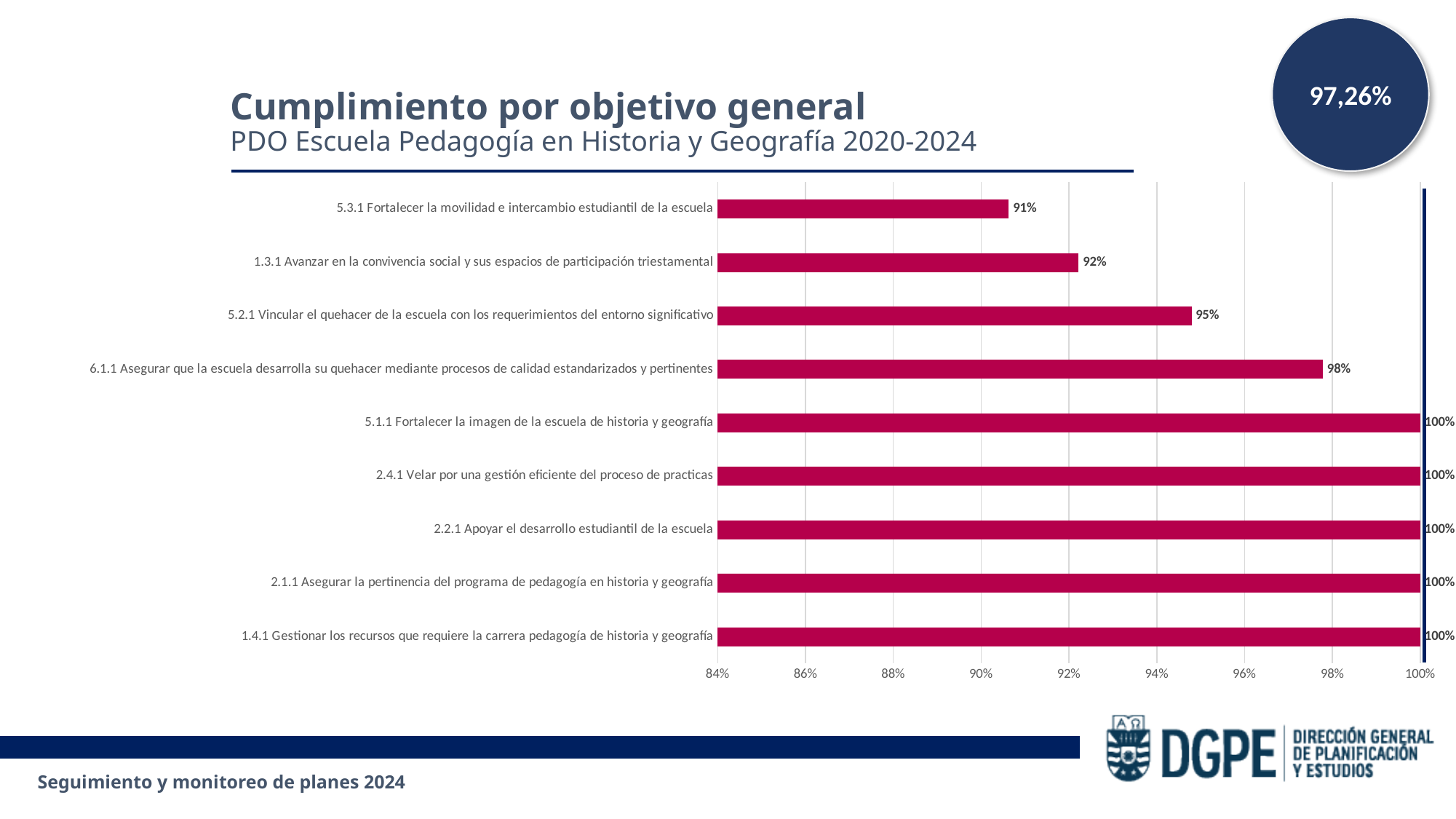
What is the difference between the values for 6.1.1 and 5.3.1? 7% How many objectives are shown in the chart? 9 What is the value for 6.1.1 Asegurar que la escuela desarrolla su quehacer mediante procesos de calidad estandarizados y pertinentes? 98% Which is larger, the value for 5.2.1 or the value for 1.3.1? 5.2.1 What is the value for 5.3.1 Fortalecer la movilidad e intercambio estudiantil de la escuela? 91% What is the value for 5.2.1 Vincular el quehacer de la escuela con los requerimientos del entorno significativo? 95% How many objectives have a value of 100%? 5 What is the value for 1.3.1 Avanzar en la convivencia social y sus espacios de participación triestamental? 92% Which objective has the lowest value? 5.3.1 Fortalecer la movilidad e intercambio estudiantil de la escuela Is the value for 5.3.1 greater or less than 92%? less What kind of chart is shown on the slide? bar chart What is the title of the chart? Cumplimiento por objetivo general